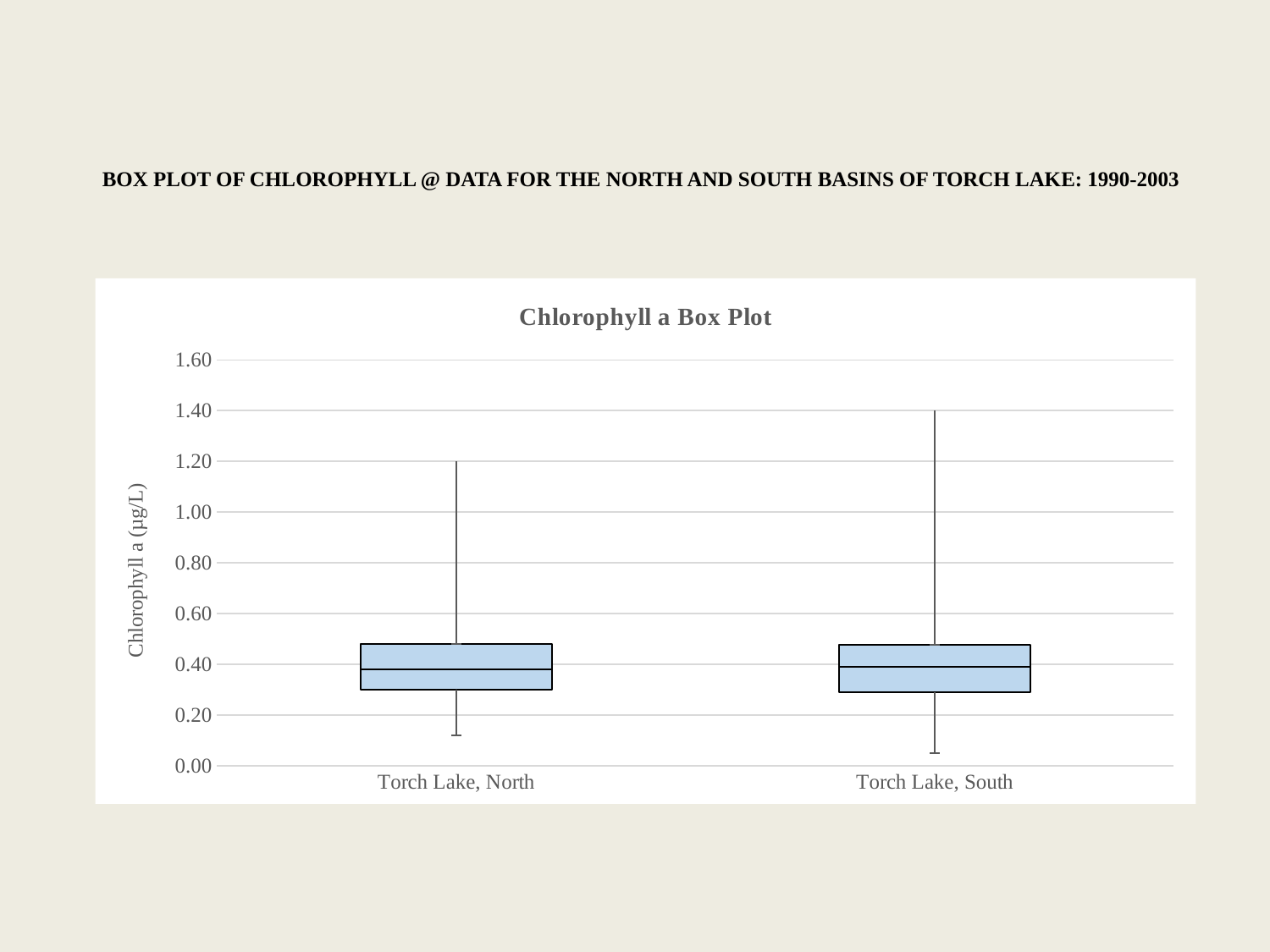
Is the bottom of the lower whisker for Torch Lake, North greater or less than 0.20? less Is the top of the box for Torch Lake, North greater or less than 0.60? less What kind of chart is shown on the slide? box plot What is the label of the y axis? Chlorophyll a (µg/L) Which basin has the lower minimum (bottom of lower whisker) value? Torch Lake, South What value does the top of the upper whisker for Torch Lake, South reach? 1.40 Is the top of the upper whisker for Torch Lake, North greater or less than 1.00? greater Which basin has the higher maximum (top of upper whisker) value? Torch Lake, South How many categories are shown on the x axis of the box plot? 2 What is the title of the chart? Chlorophyll a Box Plot What value does the top of the upper whisker for Torch Lake, North reach? 1.20